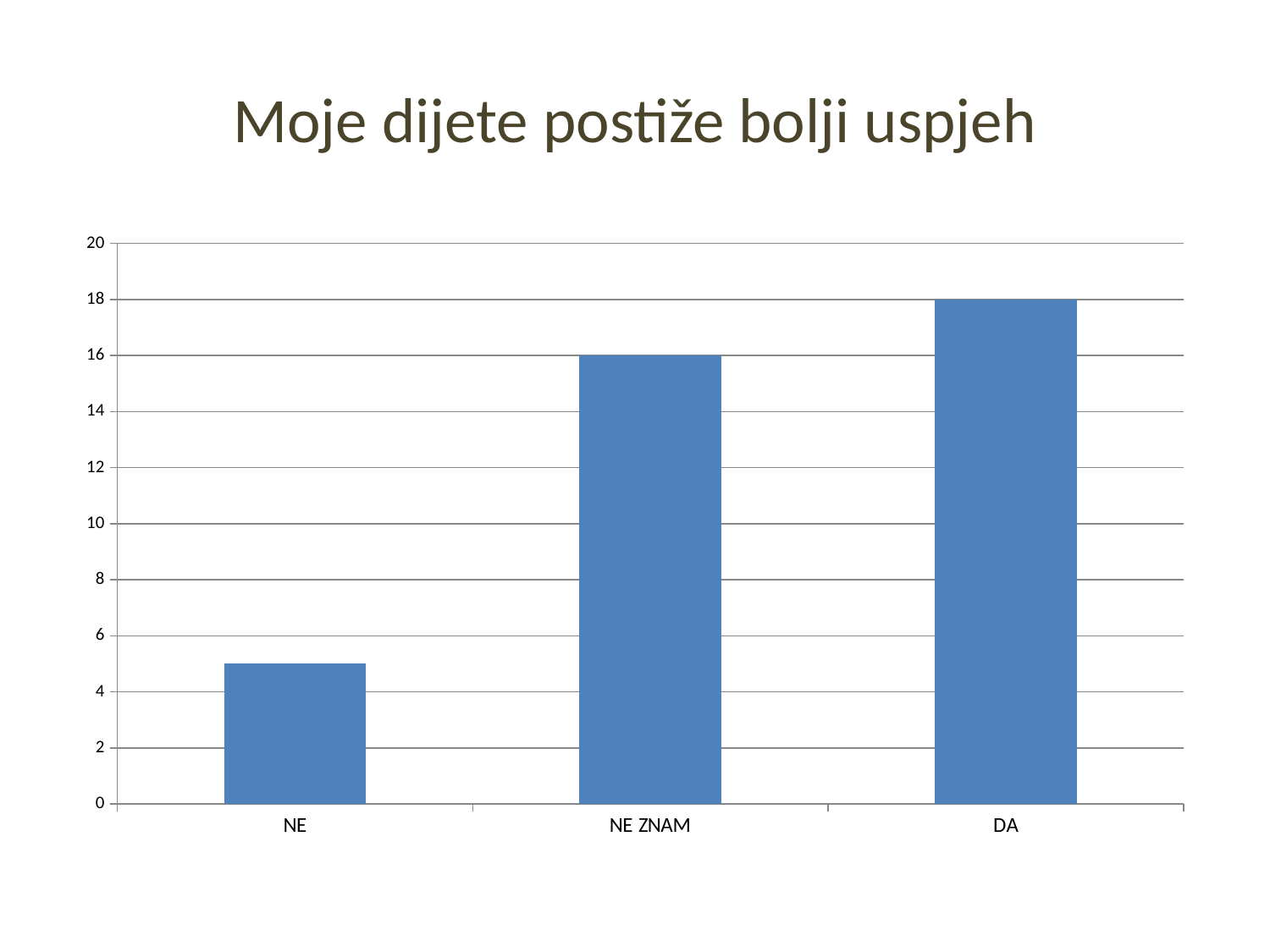
Is the value for DA greater or less than 10? greater Do the values rise or fall from left to right along the x axis? rise Which is larger, the value for NE or the value for NE ZNAM? NE ZNAM What kind of chart is shown on the slide? bar chart Which category has the lowest value? NE Which category has the highest value? DA What is the title of the slide? Moje dijete postiže bolji uspjeh What is the value for NE ZNAM? 16 Is the value for NE greater or less than 10? less What is the difference between the values for DA and NE ZNAM? 2 How many categories are shown on the x axis? 3 What is the value for DA? 18